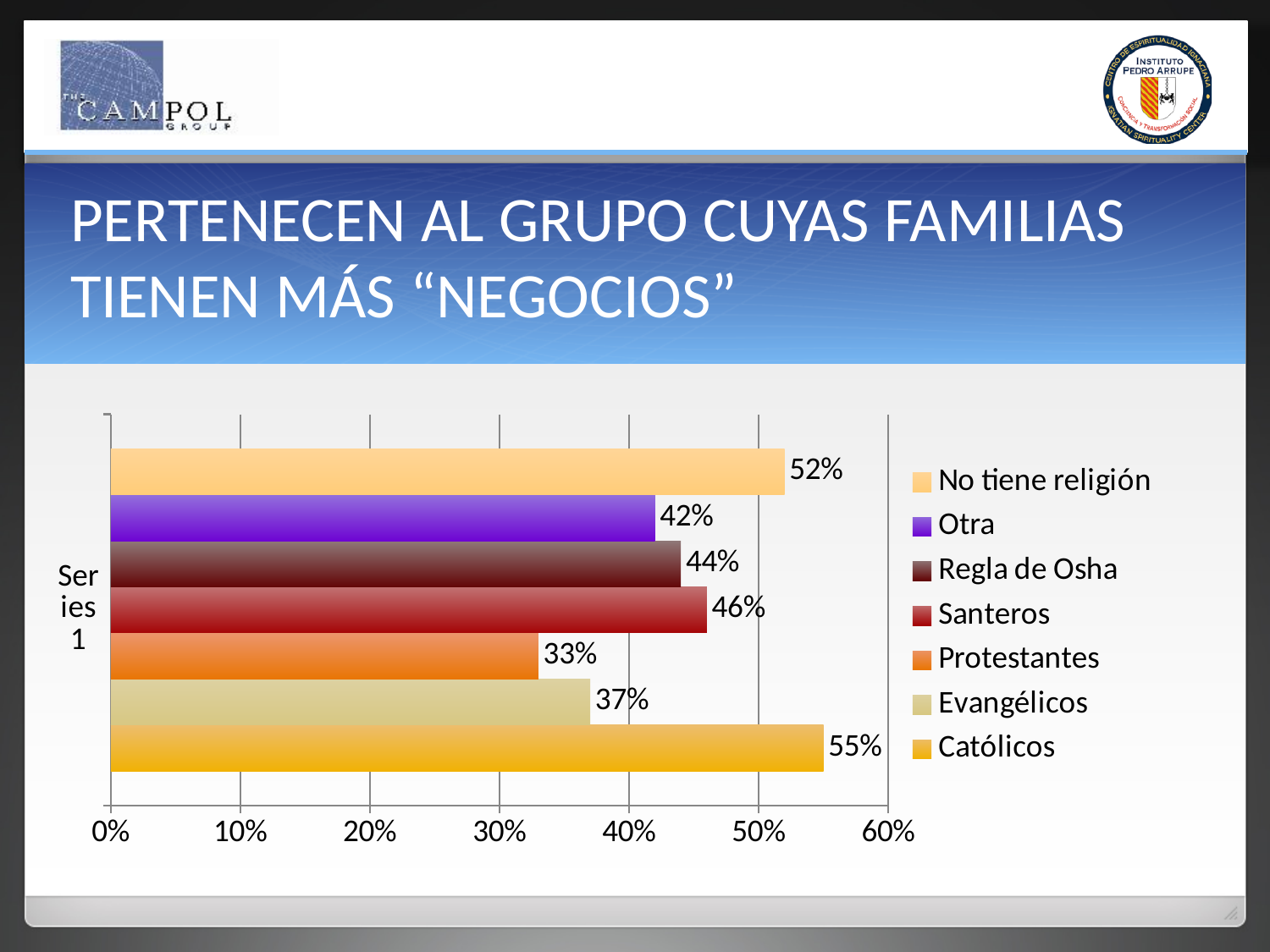
Which group has the highest value? Católicos What is the value for Protestantes? 33% What kind of chart is shown on the slide? Bar chart How many groups are shown in the chart? 7 Which group has the lowest value? Protestantes Which is larger, the value for Otra or the value for Evangélicos? Otra What is the difference between the values for Católicos and Protestantes? 22% What is the value for Católicos? 55% What is the value for Santeros? 46% What colour is the bar for Otra? Purple What is the value for No tiene religión? 52% What is the difference between the values for Santeros and Regla de Osha? 2%